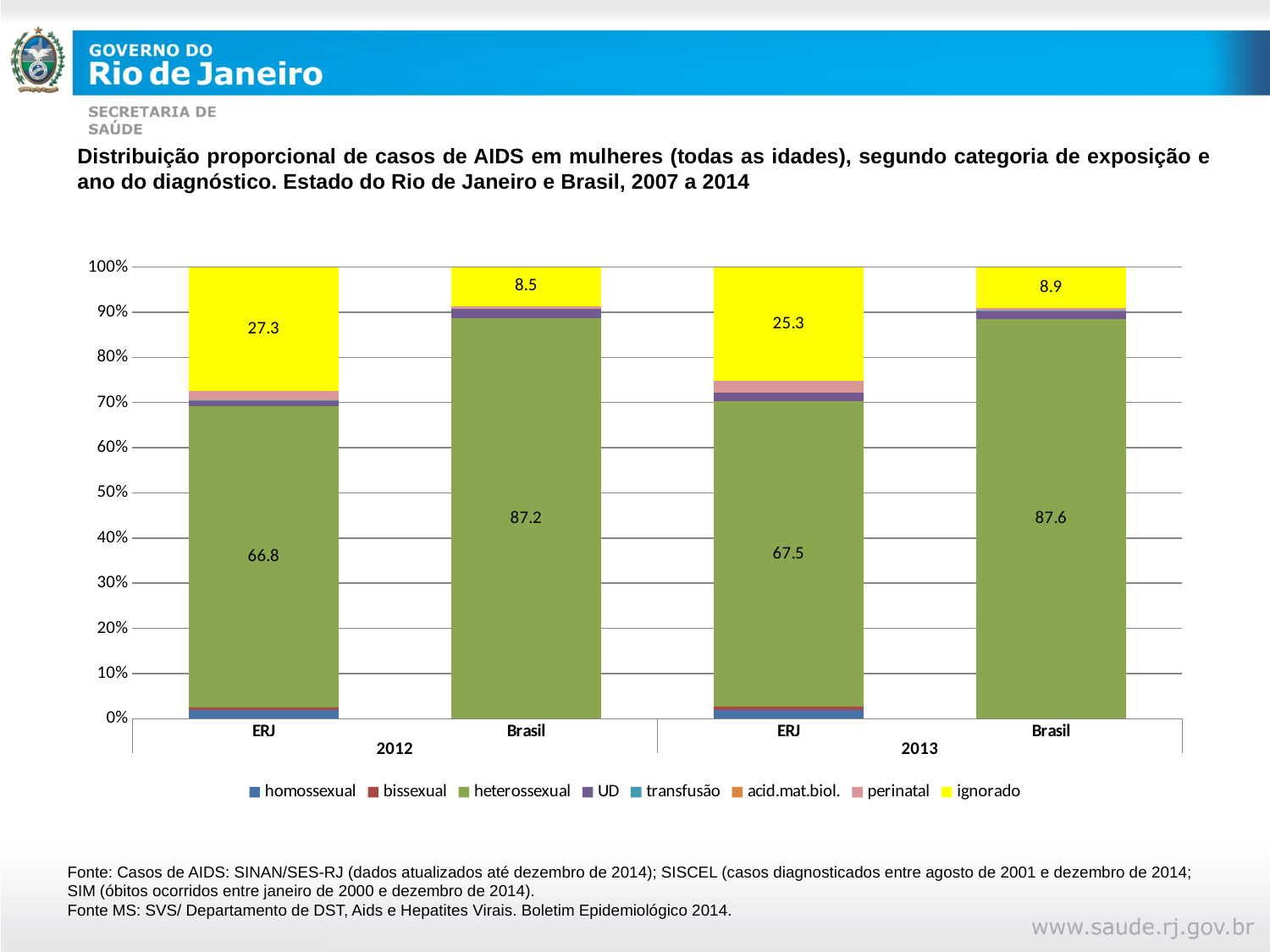
How many bars are plotted in the chart? 4 How many series does the legend list? 8 What is the difference between the ignorado values for ERJ in 2012 and ERJ in 2013? 2.0 What is the ignorado value for ERJ in 2013? 25.3 Which bar has the lowest ignorado value? Brasil 2012 What is the ignorado value for Brasil in 2012? 8.5 Which series is shown in yellow in the legend? ignorado What is the heterossexual value for Brasil in 2013? 87.6 What is the heterossexual value for ERJ in 2012? 66.8 Which is larger, the heterossexual value for ERJ in 2013 or for Brasil in 2013? Brasil 2013 Which bar has the highest heterossexual value? Brasil 2013 What type of chart is shown on the slide? stacked bar chart